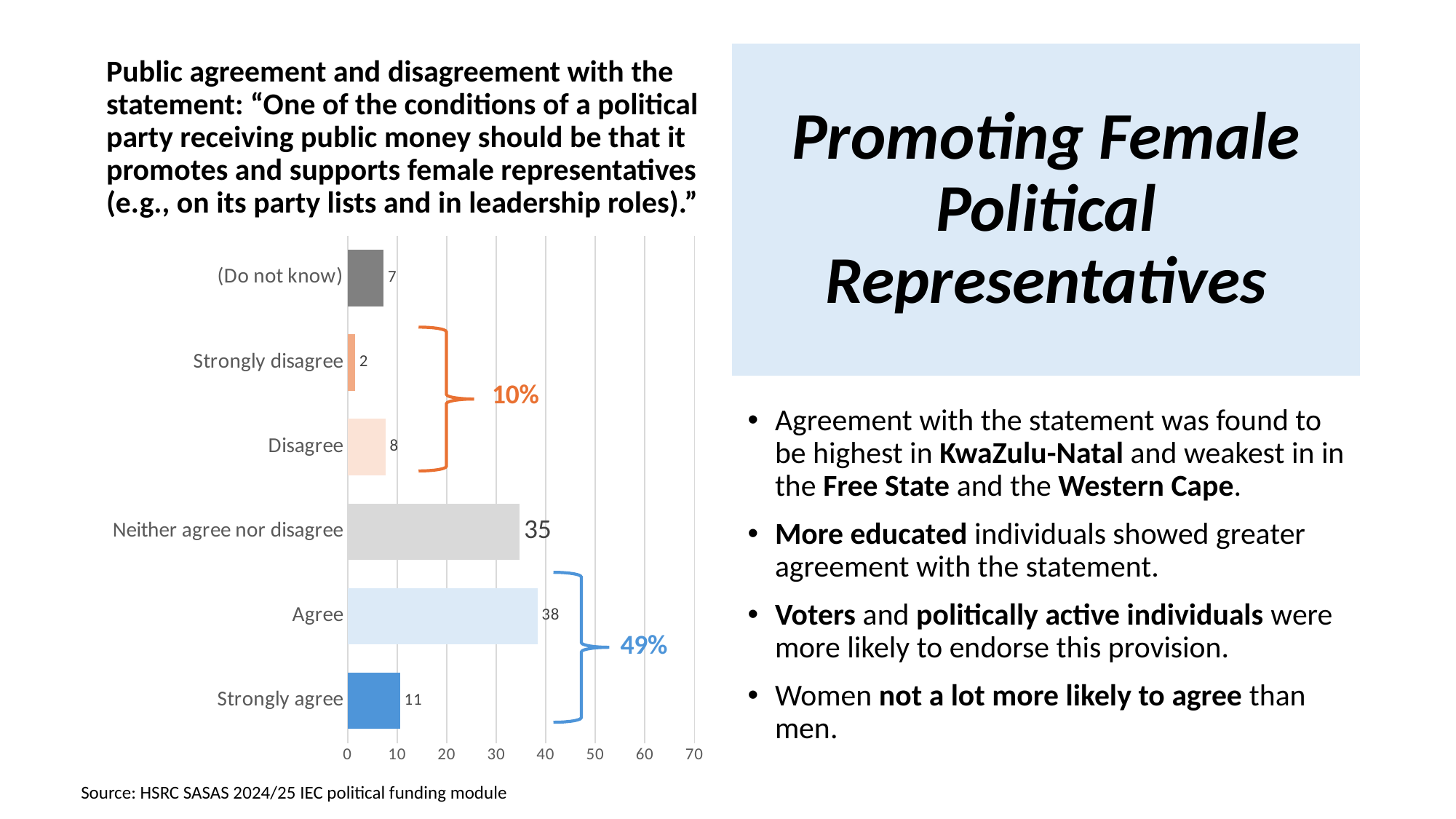
What is the value for Strongly agree? 11 What is the difference between the values for Agree and Neither agree nor disagree? 3 Is the value for Neither agree nor disagree greater or less than 30? greater Which category has the highest value? Agree What kind of chart is shown on the slide? Bar chart Which category has the lowest value? Strongly disagree What is the value for Neither agree nor disagree? 35 What is the value for Strongly disagree? 2 Which is larger, the value for Disagree or the value for Strongly agree? Strongly agree What combined percentage is shown by the bracket grouping Agree and Strongly agree? 49% How many categories are shown in the chart? 6 What is the value for Agree? 38